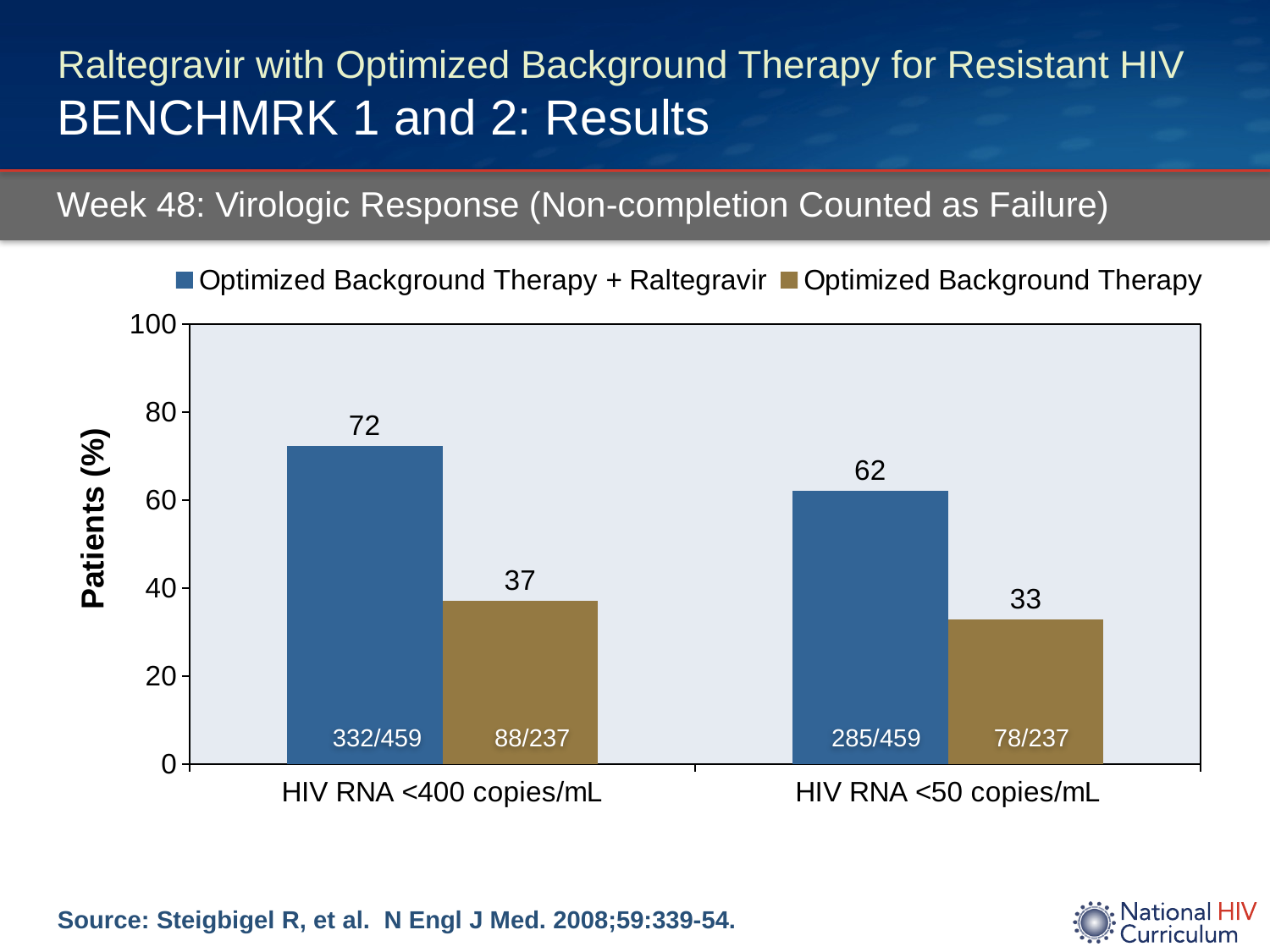
What fraction of patients is printed on the Optimized Background Therapy + Raltegravir bar for HIV RNA <50 copies/mL? 285/459 Which bar shows the lowest percentage of patients? Optimized Background Therapy, HIV RNA <50 copies/mL How many series does the legend list? 2 For HIV RNA <50 copies/mL, which group has the larger percentage of patients? Optimized Background Therapy + Raltegravir Which bar shows the highest percentage of patients? Optimized Background Therapy + Raltegravir, HIV RNA <400 copies/mL How many categories are shown on the x axis? 2 What kind of chart is shown on the slide? Bar chart What is the difference in percentage points between the two groups for HIV RNA <50 copies/mL? 29 What percentage of patients in the Optimized Background Therapy + Raltegravir group achieved HIV RNA <400 copies/mL? 72 What is the value for Optimized Background Therapy at HIV RNA <400 copies/mL? 37 What is the difference in percentage points between the two groups for HIV RNA <400 copies/mL? 35 What percentage of patients in the Optimized Background Therapy group achieved HIV RNA <50 copies/mL? 33